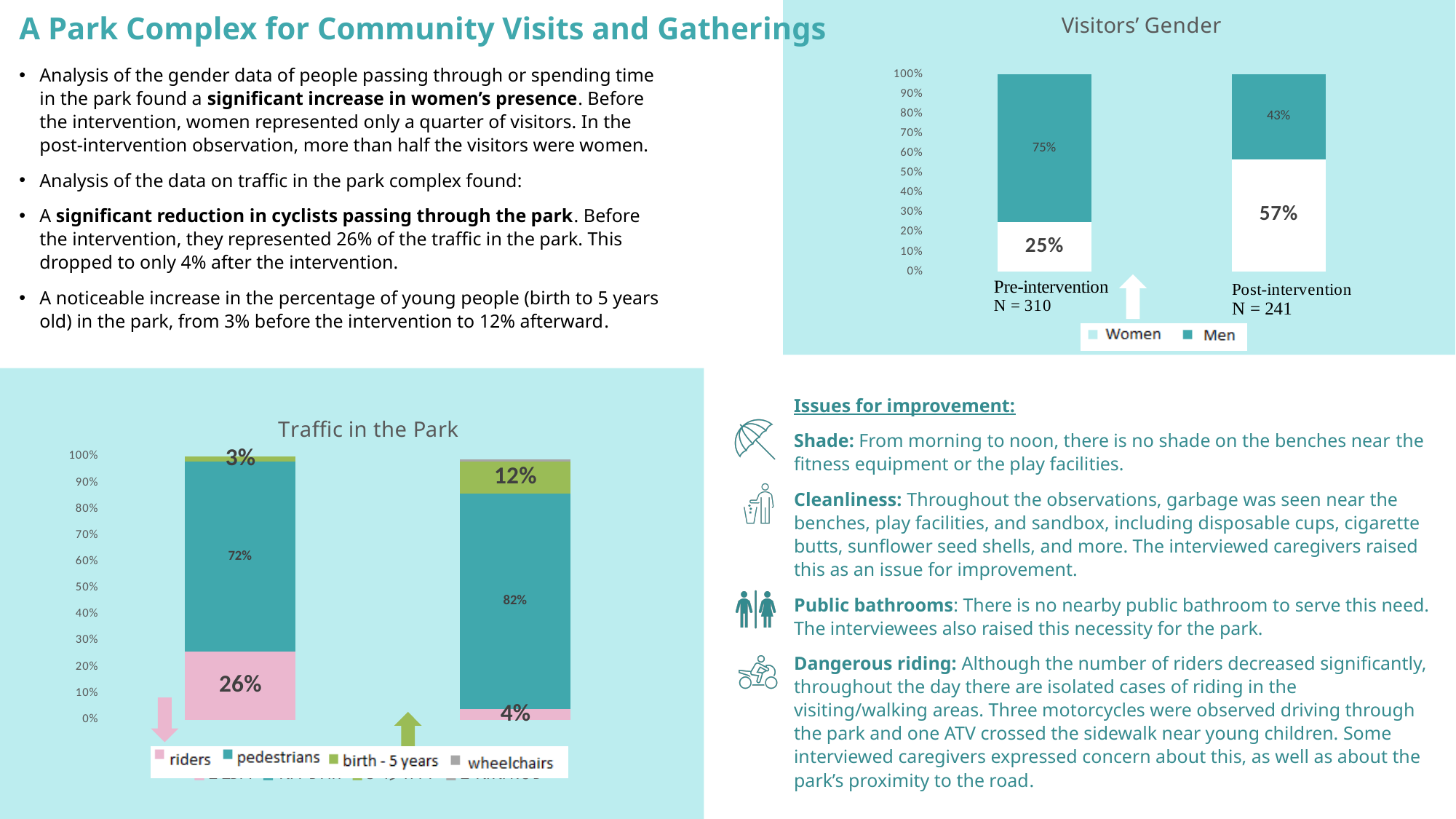
How many series does the legend of the Traffic in the Park chart list? 4 In the Traffic in the Park chart, what percentage of traffic in the right bar is pedestrians? 82% In the Traffic in the Park chart, what is the difference in the birth - 5 years share between the right bar (12%) and the left bar (3%)? 9 percentage points In the Visitors' Gender chart, by how many percentage points did the share of women increase from pre-intervention to post-intervention? 32 percentage points In the Visitors' Gender chart, what percentage of visitors were women pre-intervention? 25% In the Visitors' Gender chart, what is the sample size (N) for the pre-intervention bar? N = 310 In the Visitors' Gender chart, which group is larger post-intervention, women or men? Women In the Visitors' Gender chart, what percentage of visitors were men post-intervention? 43% How many series does the legend of the Visitors' Gender chart list? 2 In the Traffic in the Park chart, which series is the largest segment in the left bar? pedestrians In the Traffic in the Park chart, what percentage of traffic in the left bar is riders? 26% What kind of chart is the Traffic in the Park chart? Stacked bar chart